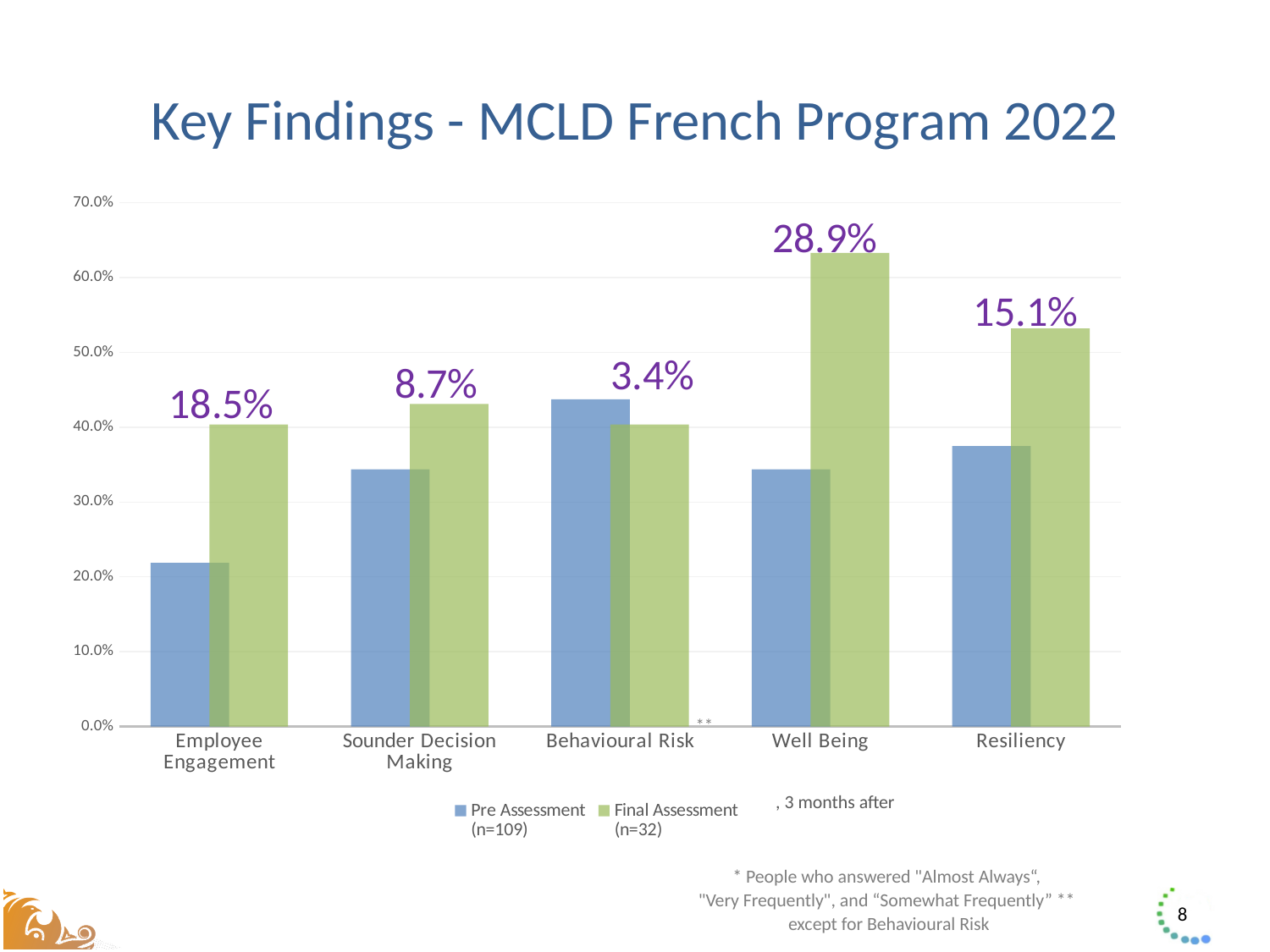
Which category has the lowest Pre Assessment (n=109) bar? Employee Engagement Is the Pre Assessment (n=109) value for Employee Engagement greater or less than 30.0%? less How many series does the chart's legend list? 2 Is the Pre Assessment (n=109) value for Behavioural Risk greater or less than 40.0%? greater What is the title of the slide containing the chart? Key Findings - MCLD French Program 2022 What percentage label is printed above the Well Being group of bars? 28.9% For Behavioural Risk, which bar is taller: Pre Assessment (n=109) or Final Assessment (n=32)? Pre Assessment (n=109) Which category has the highest Final Assessment (n=32) bar? Well Being How many categories are shown along the x axis of the chart? 5 What kind of chart is shown on the slide? bar chart Is the Final Assessment (n=32) value for Well Being greater or less than 60.0%? greater